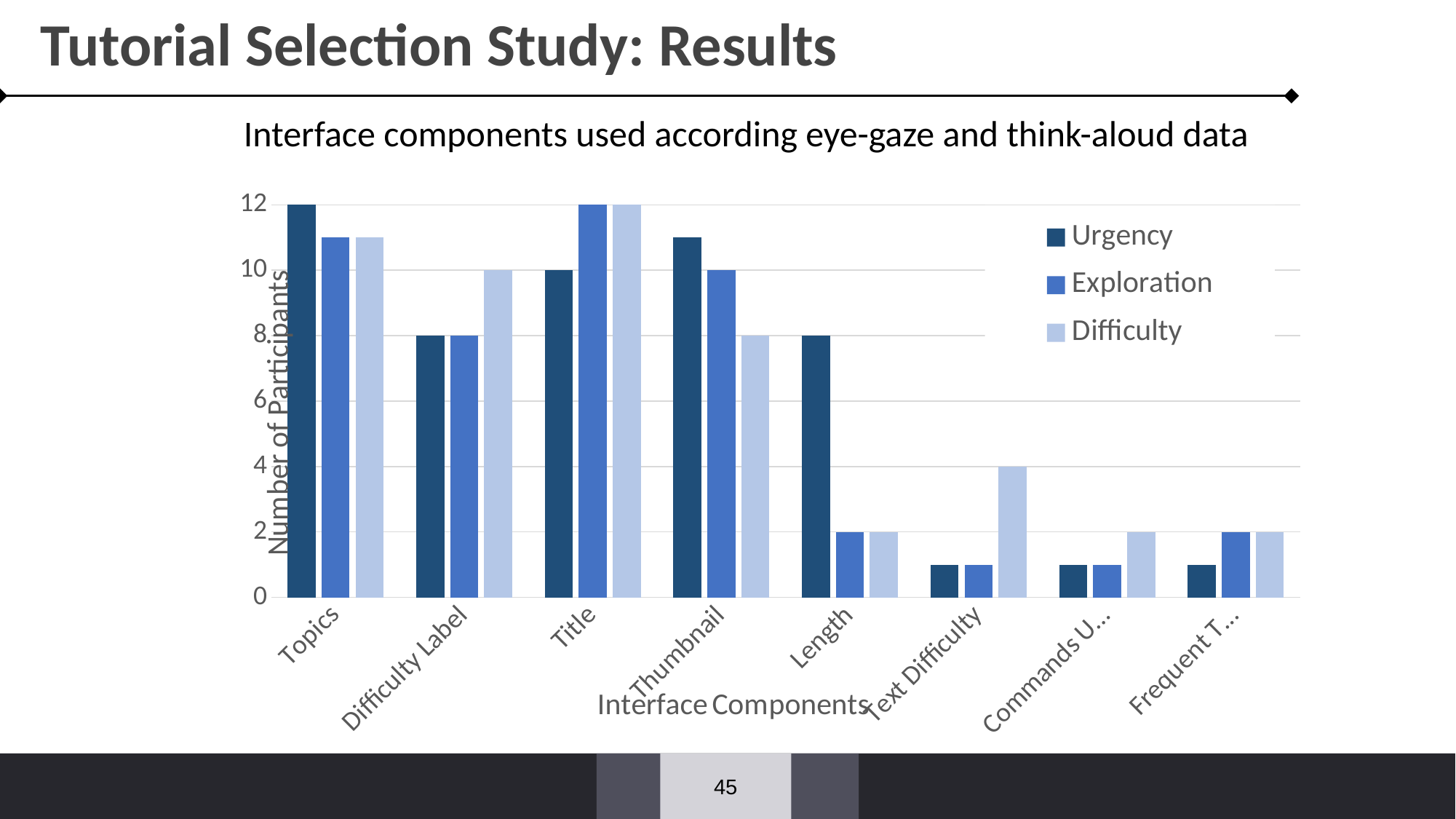
How many interface component categories are shown on the x axis? 8 Is the Urgency value for Thumbnail greater or less than 10? greater How many series does the legend list? 3 What is the Urgency value for Topics? 12 What is the title of the chart? Interface components used according eye-gaze and think-aloud data What kind of chart is shown on the slide? bar chart What is the Urgency value for Length? 8 What is the Difficulty value for Difficulty Label? 10 What is the difference between the Urgency value for Title and the Urgency value for Length? 2 Which is larger for Thumbnail: the Exploration value or the Difficulty value? Exploration What is the Exploration value for Title? 12 What is the Difficulty value for Text Difficulty? 4